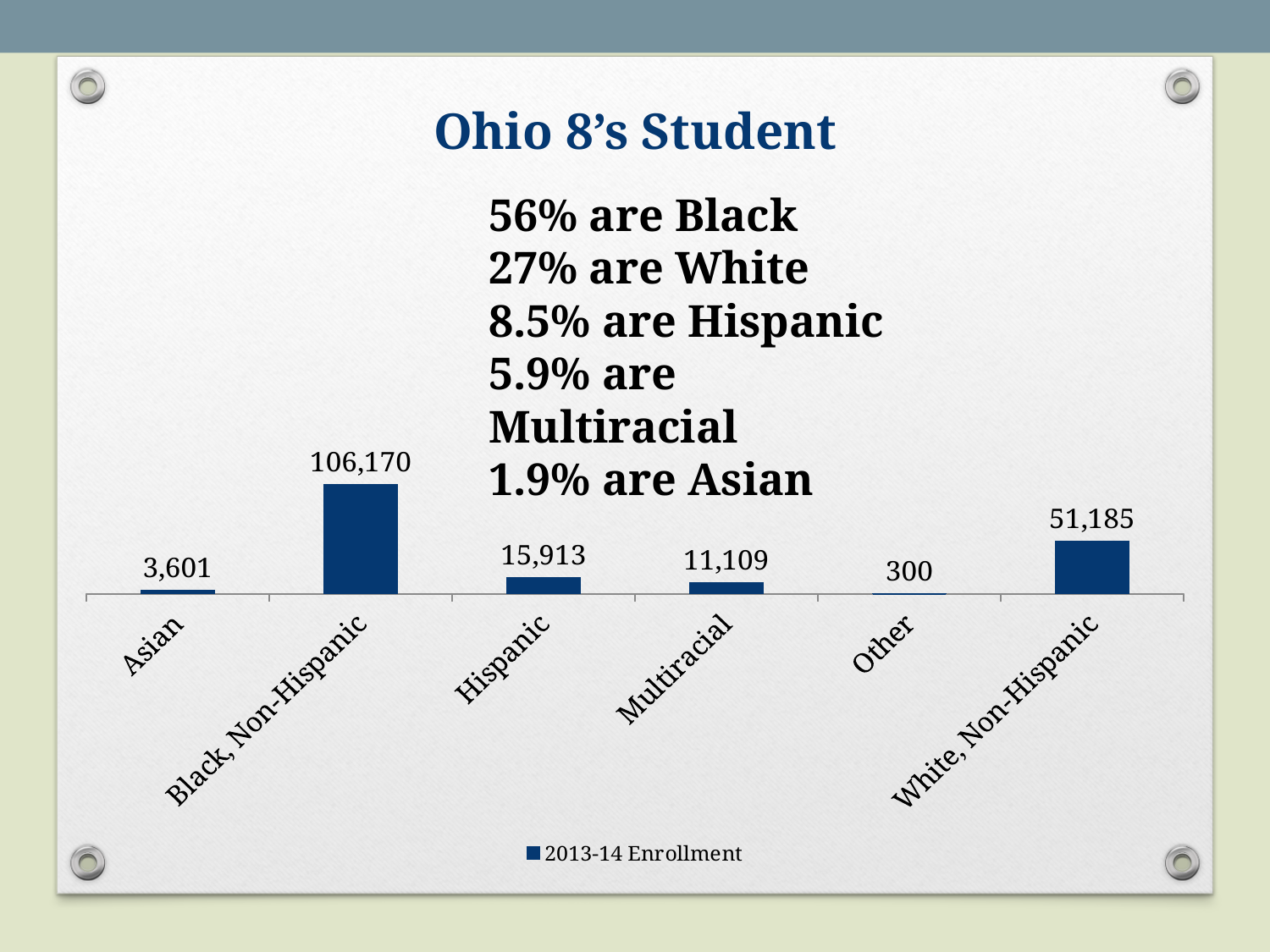
What is the 2013-14 enrollment for White, Non-Hispanic students? 51,185 Which category has the lowest 2013-14 enrollment? Other What is the difference in enrollment between Black, Non-Hispanic and White, Non-Hispanic students? 54,985 What series does the chart legend list? 2013-14 Enrollment What is the 2013-14 enrollment for Black, Non-Hispanic students? 106,170 How many categories are shown on the x axis of the chart? 6 What is the 2013-14 enrollment for Hispanic students? 15,913 What type of chart is shown on the slide? Bar chart What is the difference in enrollment between Hispanic and Multiracial students? 4,804 Which has a larger enrollment, Multiracial or Asian? Multiracial What is the 2013-14 enrollment for Asian students? 3,601 Which category has the highest 2013-14 enrollment? Black, Non-Hispanic